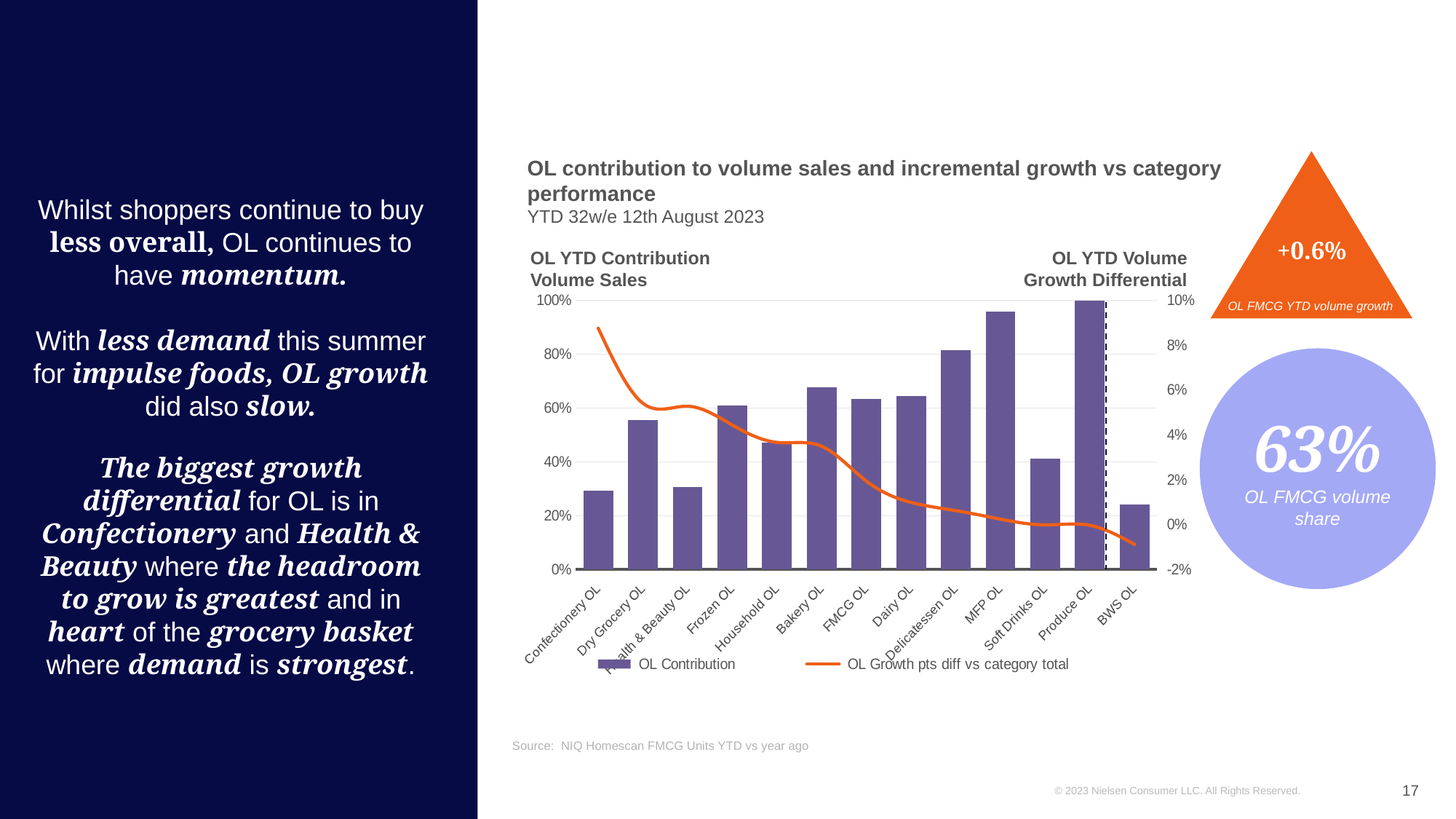
What type of chart is shown on the slide? Bar chart with a line series overlaid Does the OL Growth pts diff vs category total line generally rise or fall from left to right across the categories? Fall Is the OL Contribution value for Confectionery OL greater or less than 40%? less Which has a larger OL Contribution bar, Dry Grocery OL or Frozen OL? Frozen OL How many categories are shown on the x axis of the chart? 13 Which category has the highest OL Contribution bar? Produce OL Is the OL Contribution value for MFP OL greater or less than 80%? greater Which category has the lowest OL Contribution bar? BWS OL Is the OL Contribution value for Household OL greater or less than 60%? less What is the title of the chart? OL contribution to volume sales and incremental growth vs category performance How many series does the chart legend list? 2 Which category has the highest point on the OL Growth pts diff vs category total line? Confectionery OL